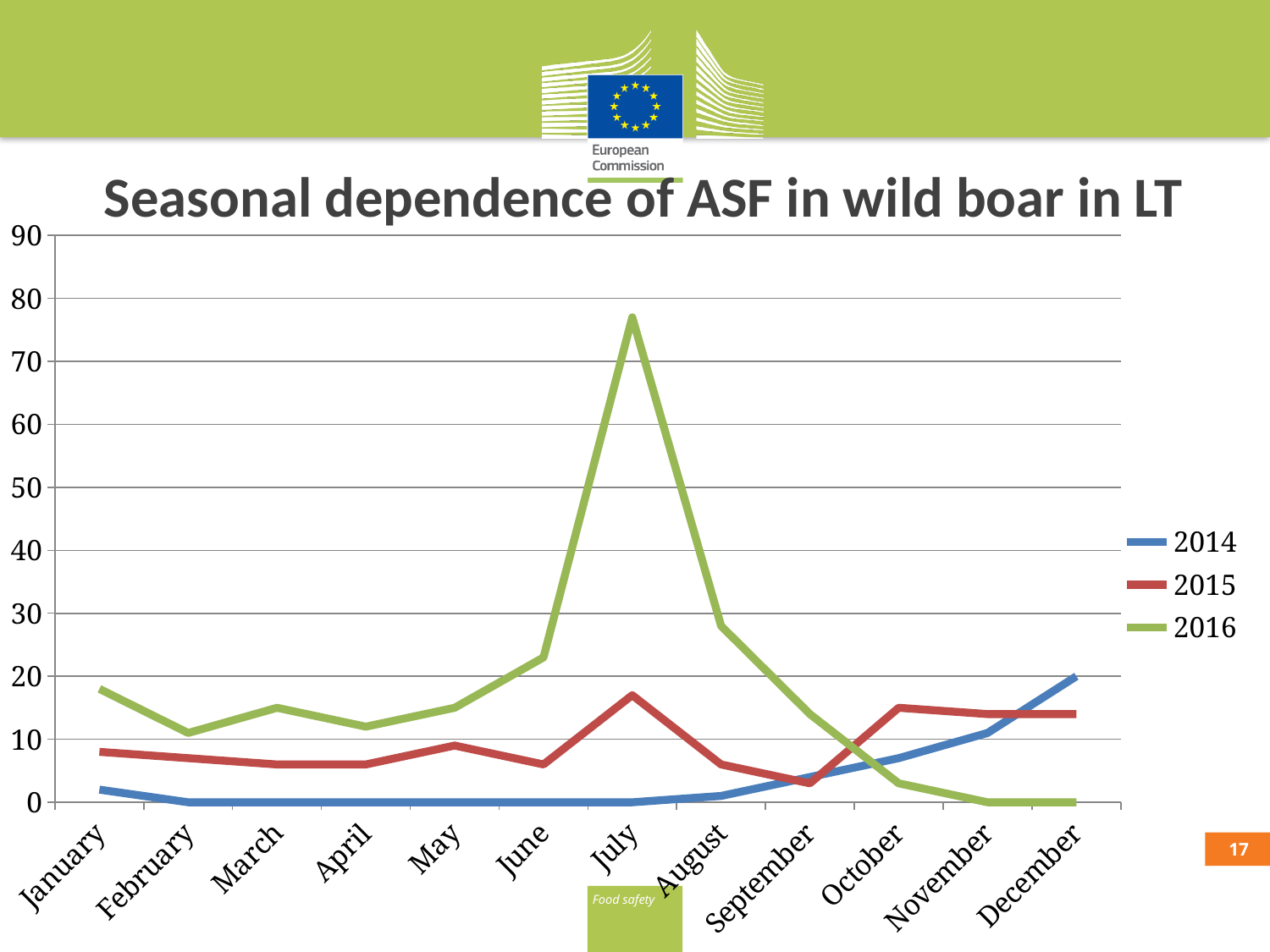
What kind of chart is shown on the slide? line chart Does the 2014 series rise or fall from September to December? rise How many months are plotted along the x axis? 12 What is the value for 2014 in December? 20 How many series does the legend list? 3 Is the value for 2016 in July greater or less than 70? greater In July, which series has the larger value, 2015 or 2016? 2016 Is the value for 2016 in July greater or less than 80? less What is the title of the chart? Seasonal dependence of ASF in wild boar in LT Is the value for 2015 in October greater or less than 10? greater In which month does the 2016 series reach its highest value? July What is the value for 2016 in December? 0